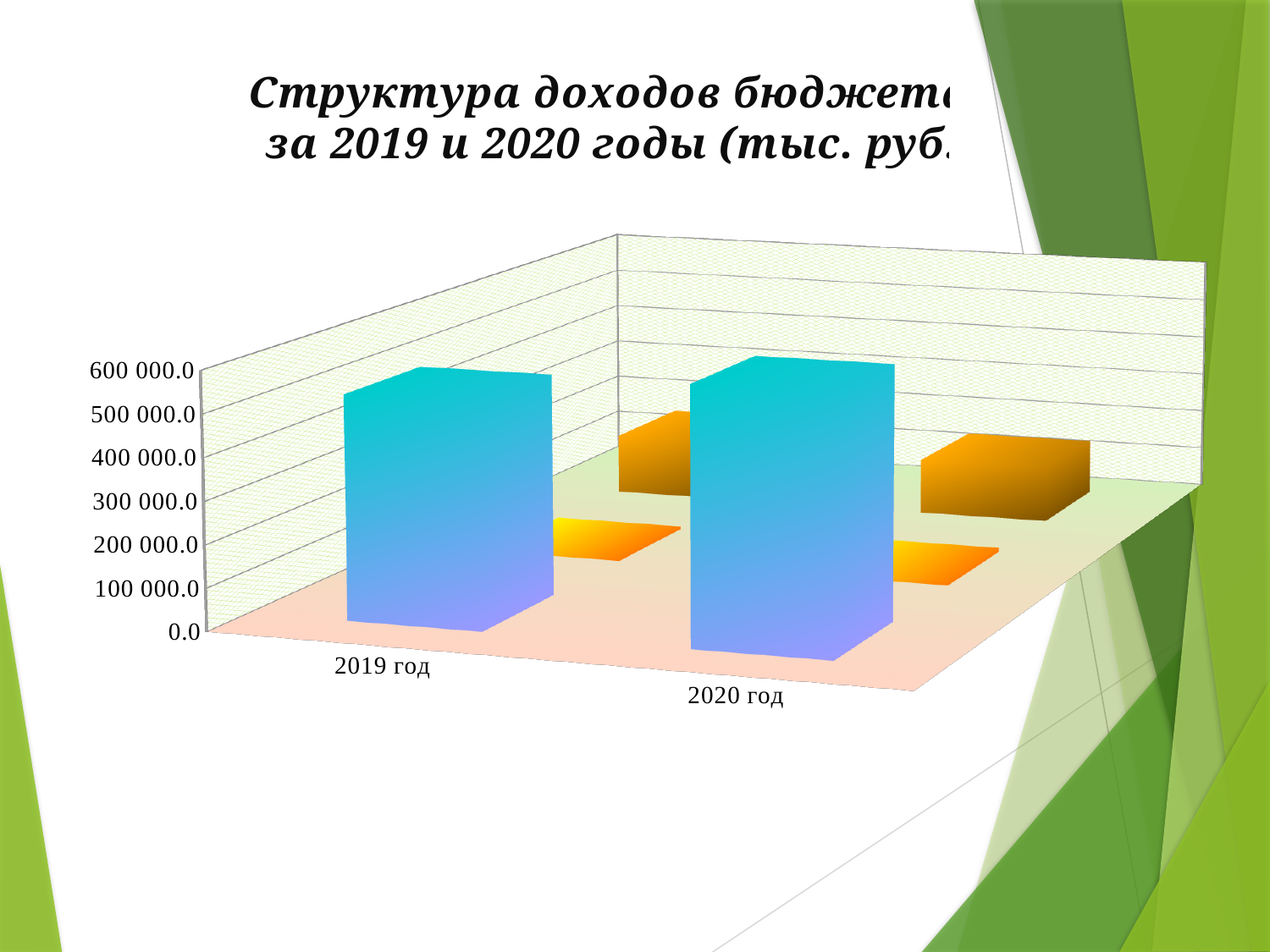
What is the highest value shown on the vertical axis of the chart? 600 000.0 Is the value of the orange bar for 2020 год greater or less than 300 000.0? less Which category has the taller blue bar, 2019 год or 2020 год? 2020 год What are the two categories shown on the x axis? 2019 год and 2020 год Is the value of the tallest (blue) bar for 2019 год greater or less than 300 000.0? greater What kind of chart is shown on the slide? bar chart Is the value of the tallest (blue) bar for 2020 год greater or less than 400 000.0? greater How many bars are plotted for the category 2019 год? 3 How many categories are shown on the x axis of the chart? 2